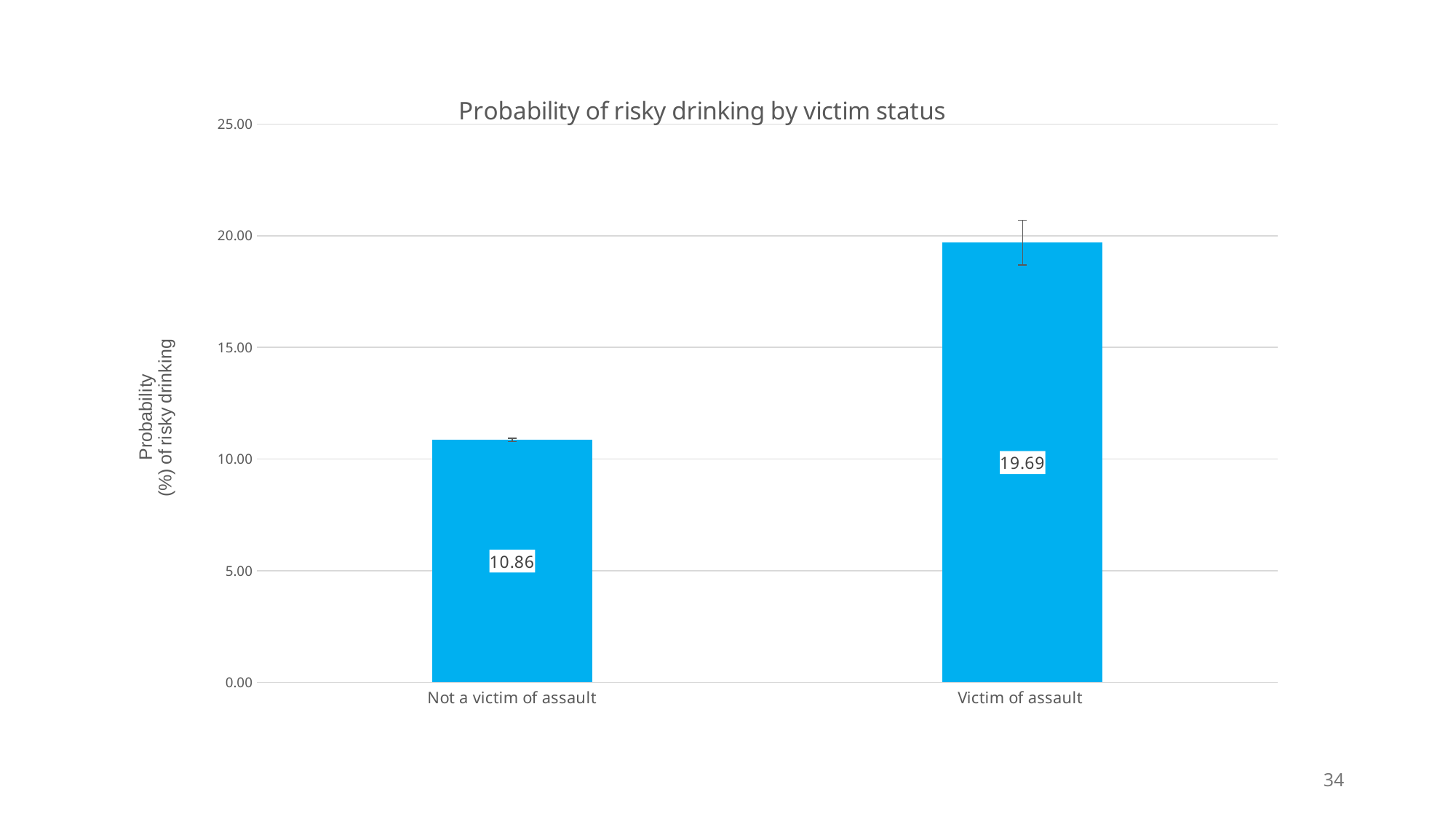
What is the label of the y axis? Probability (%) of risky drinking Is the value for "Victim of assault" greater or less than 15.00? greater What is the title of the chart? Probability of risky drinking by victim status Which category has the highest value? Victim of assault What is the difference between the values for "Victim of assault" and "Not a victim of assault"? 8.83 What kind of chart is shown on the slide? bar chart What is the value for "Not a victim of assault"? 10.86 Which is larger, the value for "Victim of assault" or for "Not a victim of assault"? Victim of assault How many categories are shown on the x axis? 2 What is the value for "Victim of assault"? 19.69 Which category has the lowest value? Not a victim of assault Is the value for "Not a victim of assault" greater or less than 15.00? less